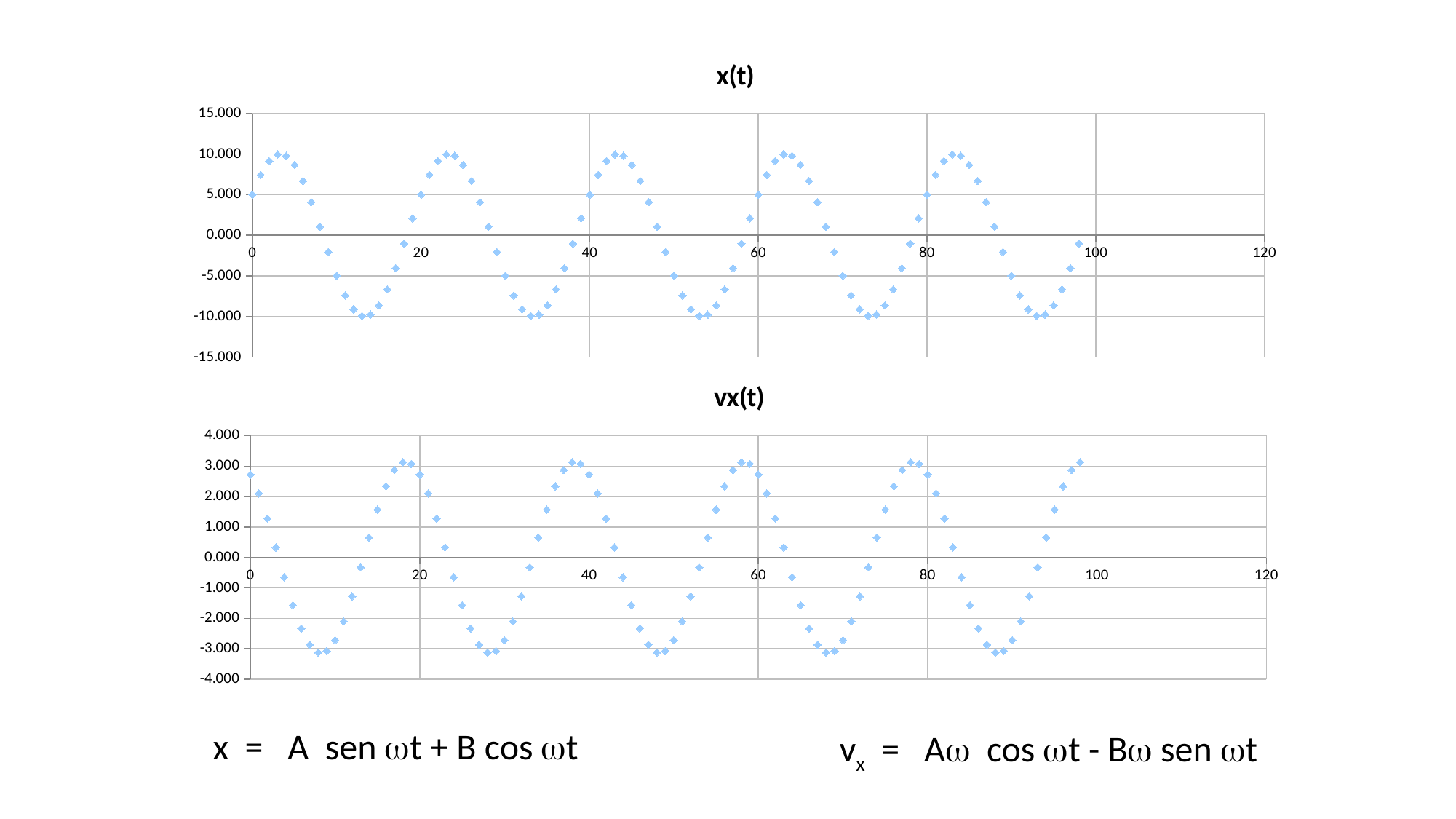
In the vx(t) chart, which is larger: the value at t = 0 or the value at t = 8? the value at t = 0 How many charts are shown on the slide? 2 In the x(t) chart, what is the value plotted at t = 0? 5.000 In the vx(t) chart, is the value at t = 18 greater or less than 2.000? greater In the x(t) chart, is the value at t = 14 greater or less than -5.000? less In the vx(t) chart, is the value at t = 8 greater or less than -2.000? less In the x(t) chart, which is larger: the value at t = 4 or the value at t = 14? the value at t = 4 What is the title of the bottom chart? vx(t) What kind of chart is the x(t) chart? scatter chart What kind of chart is the vx(t) chart? scatter chart What is the title of the top chart? x(t)